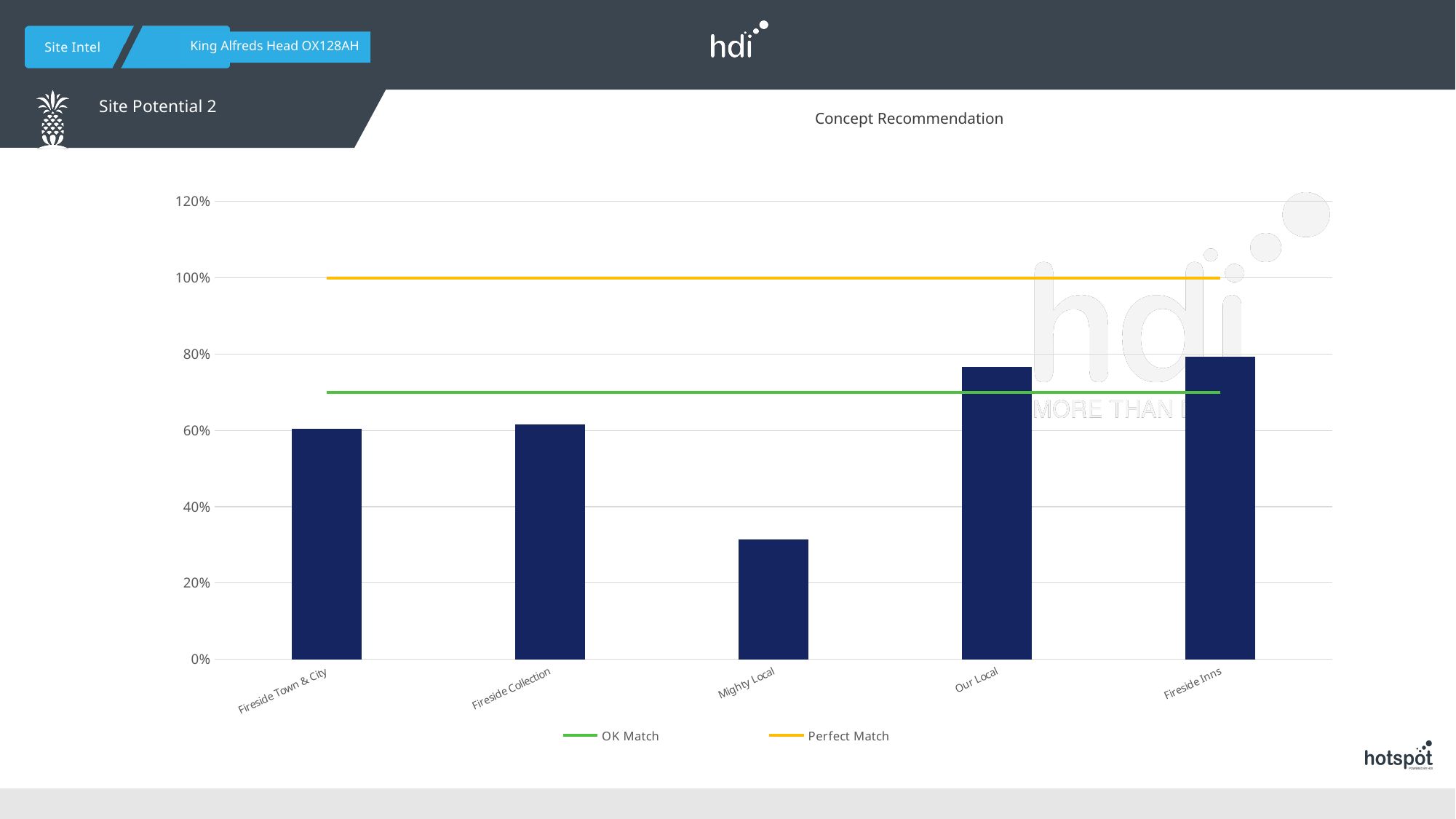
Which is larger, the value for Fireside Collection or the value for Mighty Local? Fireside Collection Is the value for Our Local greater or less than 60%? greater Which legend entry corresponds to the higher horizontal reference line, OK Match or Perfect Match? Perfect Match How many entries does the chart legend list? 2 Which category has the lowest bar in the chart? Mighty Local What kind of chart is shown on the slide? bar chart Is the value for Fireside Town & City greater or less than 40%? greater Is the value for Mighty Local greater or less than 40%? less What is the title of the chart? Concept Recommendation Which is larger, the value for Our Local or the value for Mighty Local? Our Local How many categories are shown on the x axis of the chart? 5